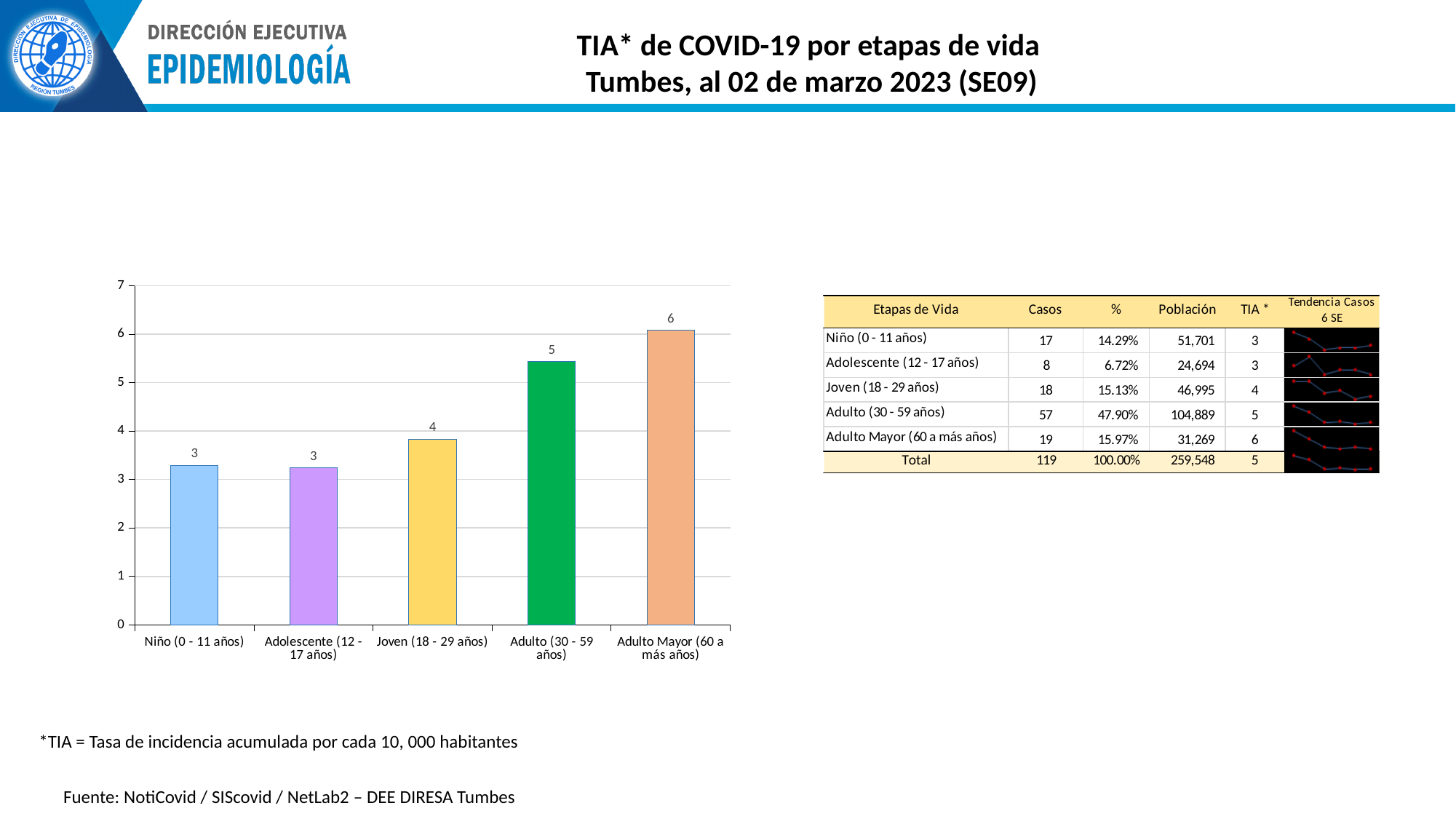
Which has a larger TIA, Adulto (30 - 59 años) or Joven (18 - 29 años)? Adulto (30 - 59 años) What colour is the bar for Adulto (30 - 59 años)? green How many life-stage categories are plotted in the bar chart? 5 Do the TIA values generally rise or fall from Niño to Adulto Mayor along the x axis? rise What is the TIA value shown for Niño (0 - 11 años)? 3 What is the TIA value shown for Adulto (30 - 59 años)? 5 What is the TIA value shown for Joven (18 - 29 años)? 4 What is the difference between the labelled TIA values for Adulto Mayor (60 a más años) and Adulto (30 - 59 años)? 1 Which life stage has the highest TIA in the bar chart? Adulto Mayor (60 a más años) What kind of chart is used to show the TIA by life stage? bar chart